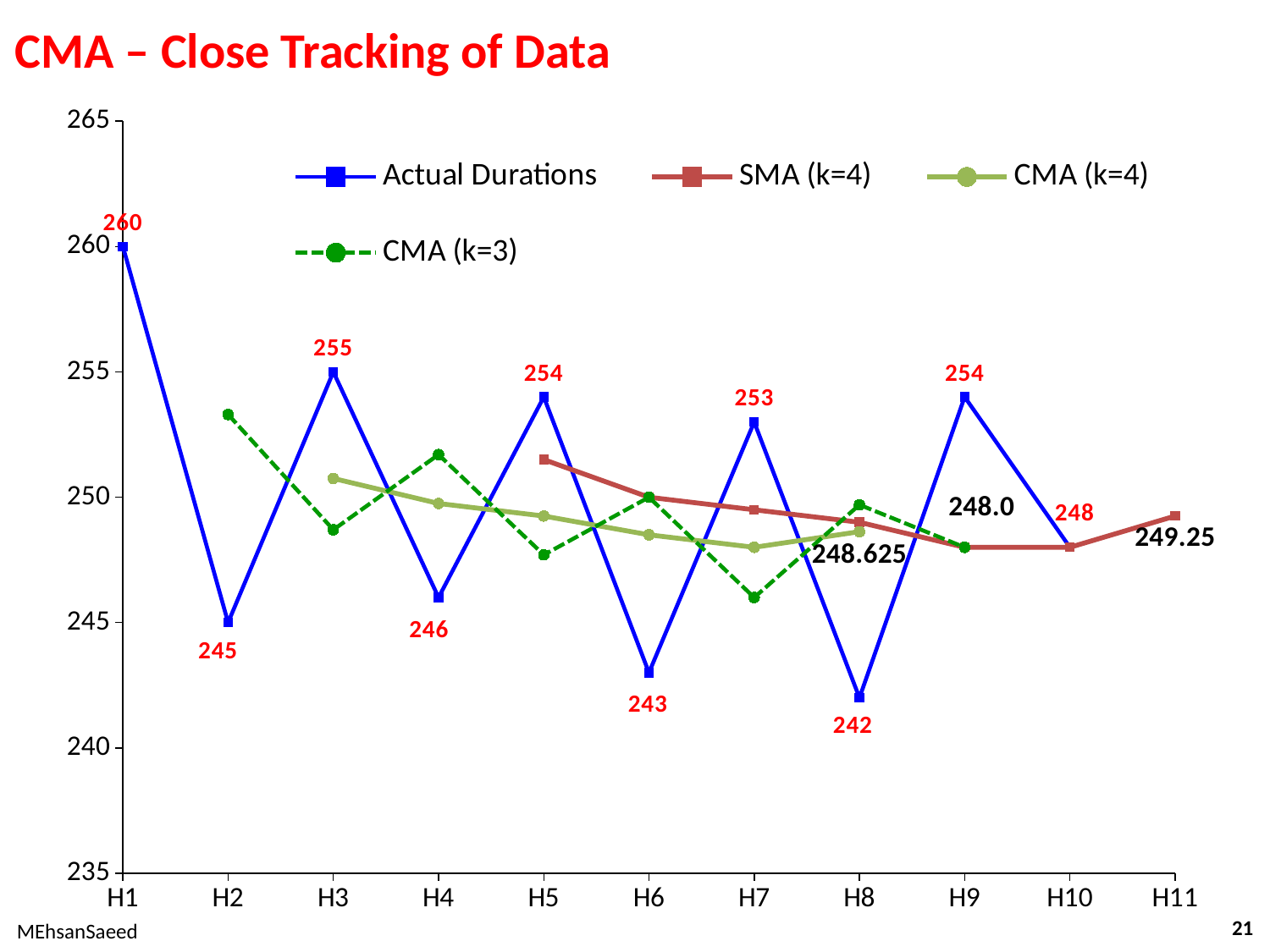
At which period is the Actual Durations value highest? H1 What is the Actual Durations value at H1? 260 What is the CMA (k=4) value at H8? 248.625 How many series does the legend list? 4 What kind of chart is shown on the slide? line chart How many periods are shown on the x axis? 11 What is the SMA (k=4) value at H11? 249.25 What is the difference between the Actual Durations values at H1 and H2? 15 At which period is the Actual Durations value lowest? H8 Which is larger, the Actual Durations value at H3 or at H5? H3 Which series is drawn with a dashed line? CMA (k=3) Is the CMA (k=3) value at H2 greater or less than 250? greater